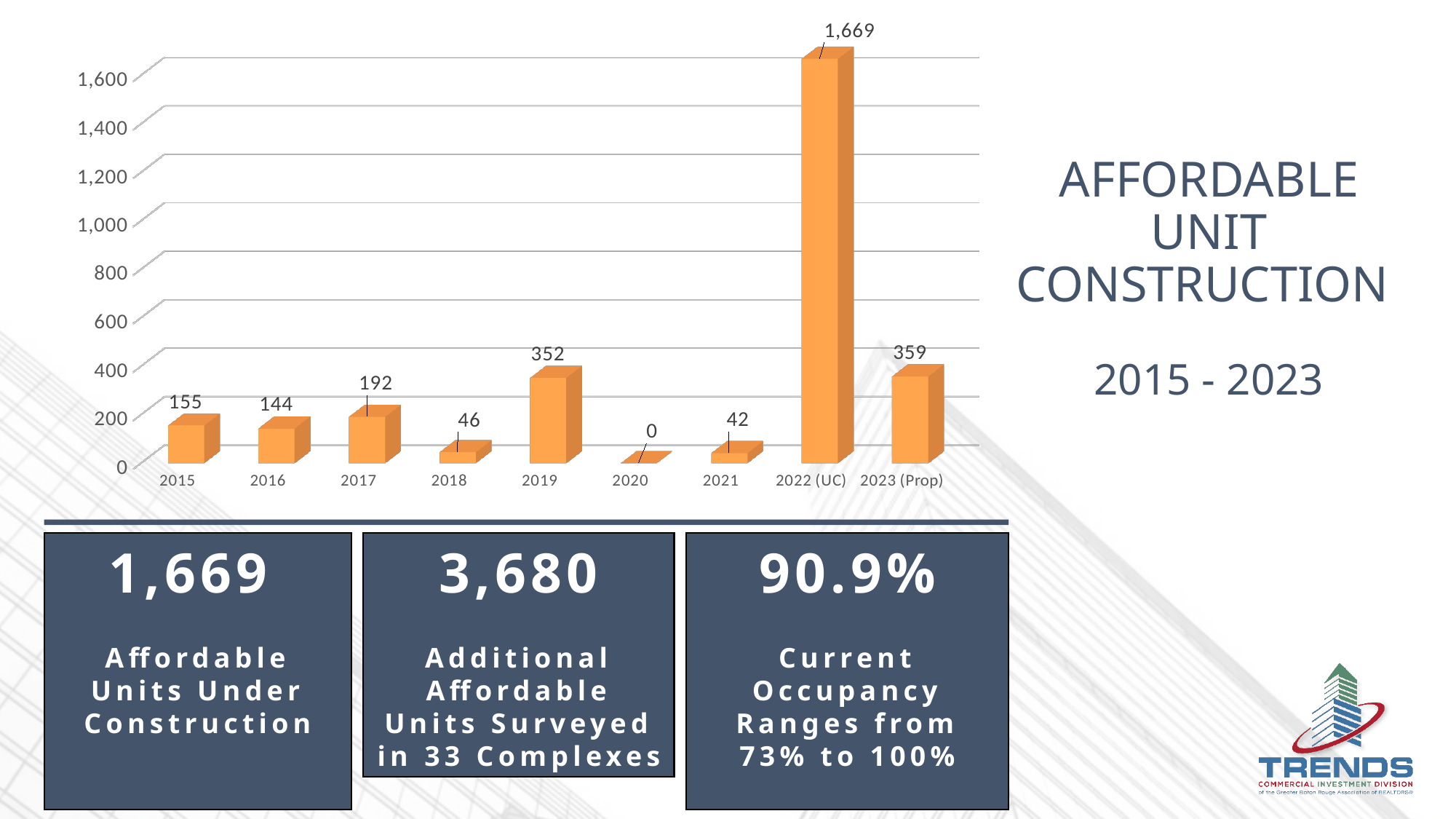
What is the value for 2019? 352 What is the difference between the values for 2022 (UC) and 2023 (Prop)? 1,310 Do the values rise or fall from 2015 to 2016? fall Is the value for 2019 greater or less than 200? greater Which is larger, the value for 2017 or the value for 2018? 2017 What is the value for 2015? 155 What is the value for 2023 (Prop)? 359 What kind of chart is shown? bar chart How many categories are shown on the x axis? 9 Which category has the lowest value? 2020 Which category has the highest value? 2022 (UC) What is the difference between the values for 2015 and 2016? 11